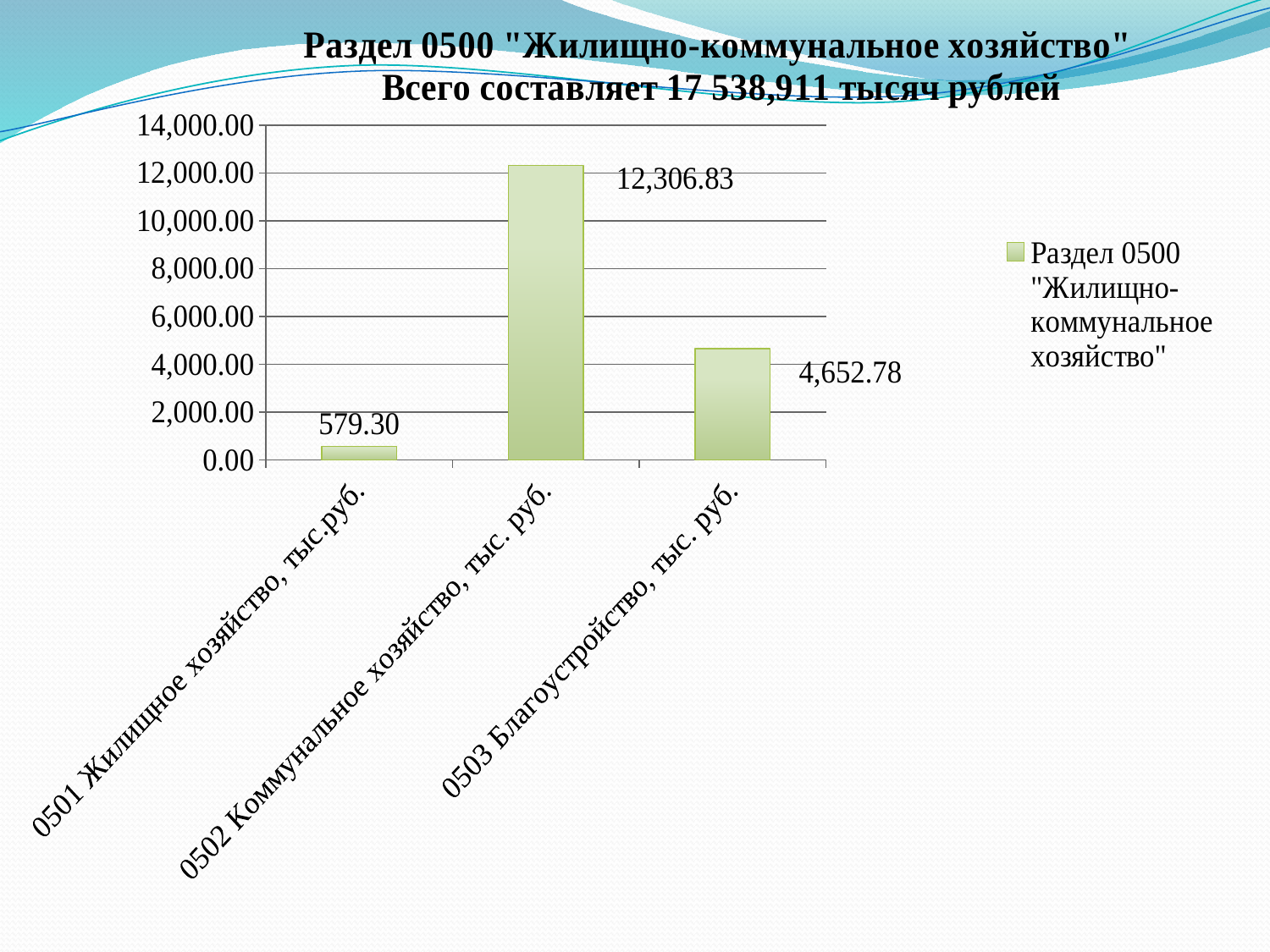
What is the value for 0501 Жилищное хозяйство? 579.30 How many categories are shown on the x axis? 3 Which category has the lowest value? 0501 Жилищное хозяйство Which is larger, the value for 0503 Благоустройство or the value for 0501 Жилищное хозяйство? 0503 Благоустройство Which category has the highest value? 0502 Коммунальное хозяйство What is the difference between the values for 0503 Благоустройство and 0501 Жилищное хозяйство? 4,073.48 How many series does the legend list? 1 What is the difference between the values for 0502 Коммунальное хозяйство and 0503 Благоустройство? 7,654.05 What is the value for 0503 Благоустройство? 4,652.78 Is the value for 0502 Коммунальное хозяйство greater or less than 12,000.00? greater What kind of chart is shown on the slide? bar chart What is the value for 0502 Коммунальное хозяйство? 12,306.83